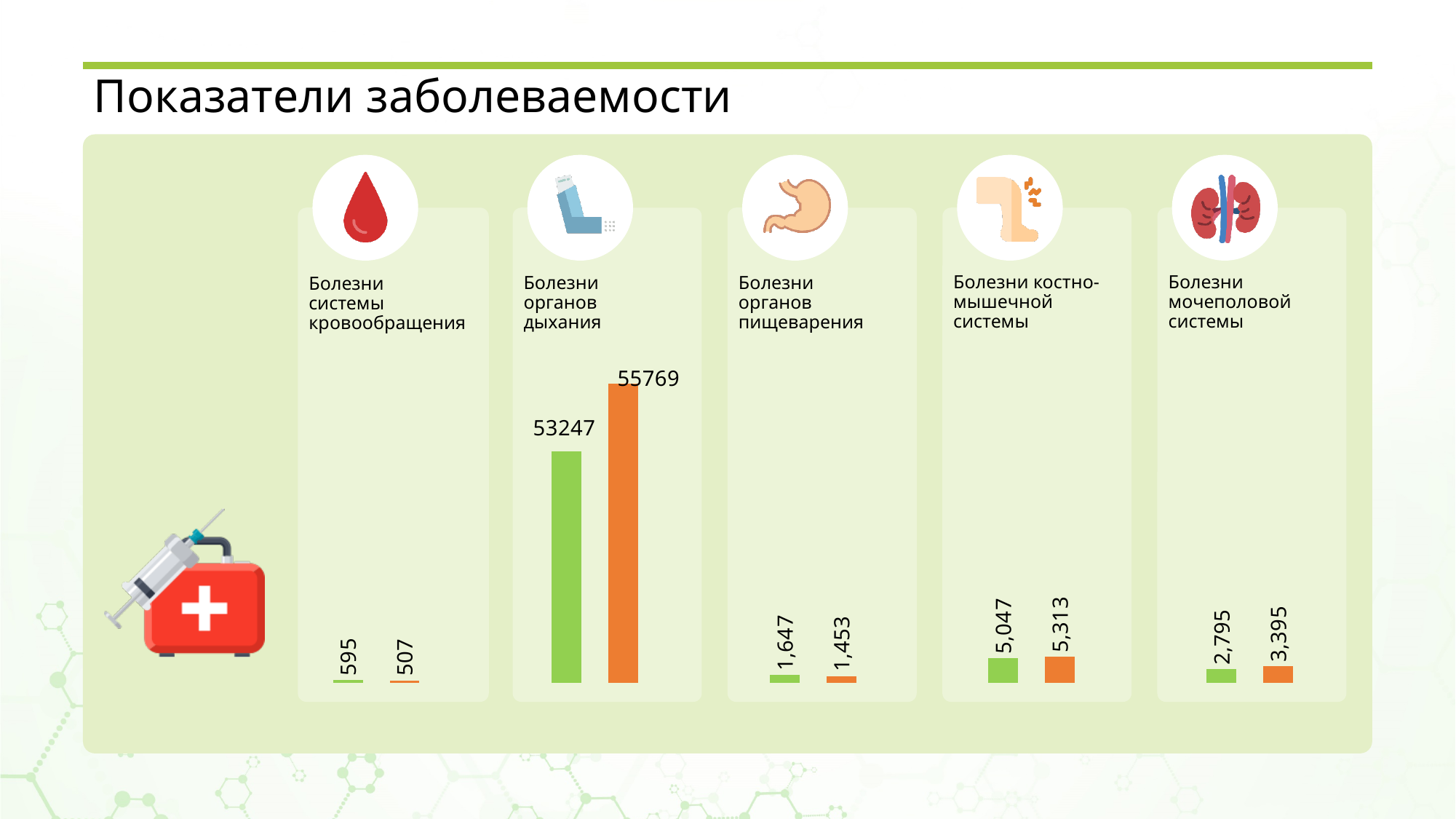
What type of chart is used for "Болезни органов дыхания"? bar chart In the chart for "Болезни мочеполовой системы", what is the difference between the orange bar and the green bar? 600 In the chart for "Болезни органов пищеварения", which bar is higher, the green or the orange one? green In the chart for "Болезни органов дыхания", what value is shown on the green bar? 53247 In the chart for "Болезни органов дыхания", what is the difference between the orange bar and the green bar? 2522 In the chart for "Болезни мочеполовой системы", what value is shown on the orange bar? 3,395 How many bars are shown in the chart for "Болезни костно-мышечной системы"? 2 In the chart for "Болезни органов пищеварения", what value is shown on the green bar? 1,647 In the chart for "Болезни системы кровообращения", what value is shown on the orange bar? 507 In the chart for "Болезни органов дыхания", what value is shown on the orange bar? 55769 In the chart for "Болезни костно-мышечной системы", which bar is higher, the green or the orange one? orange In the chart for "Болезни системы кровообращения", what is the difference between the green bar and the orange bar? 88